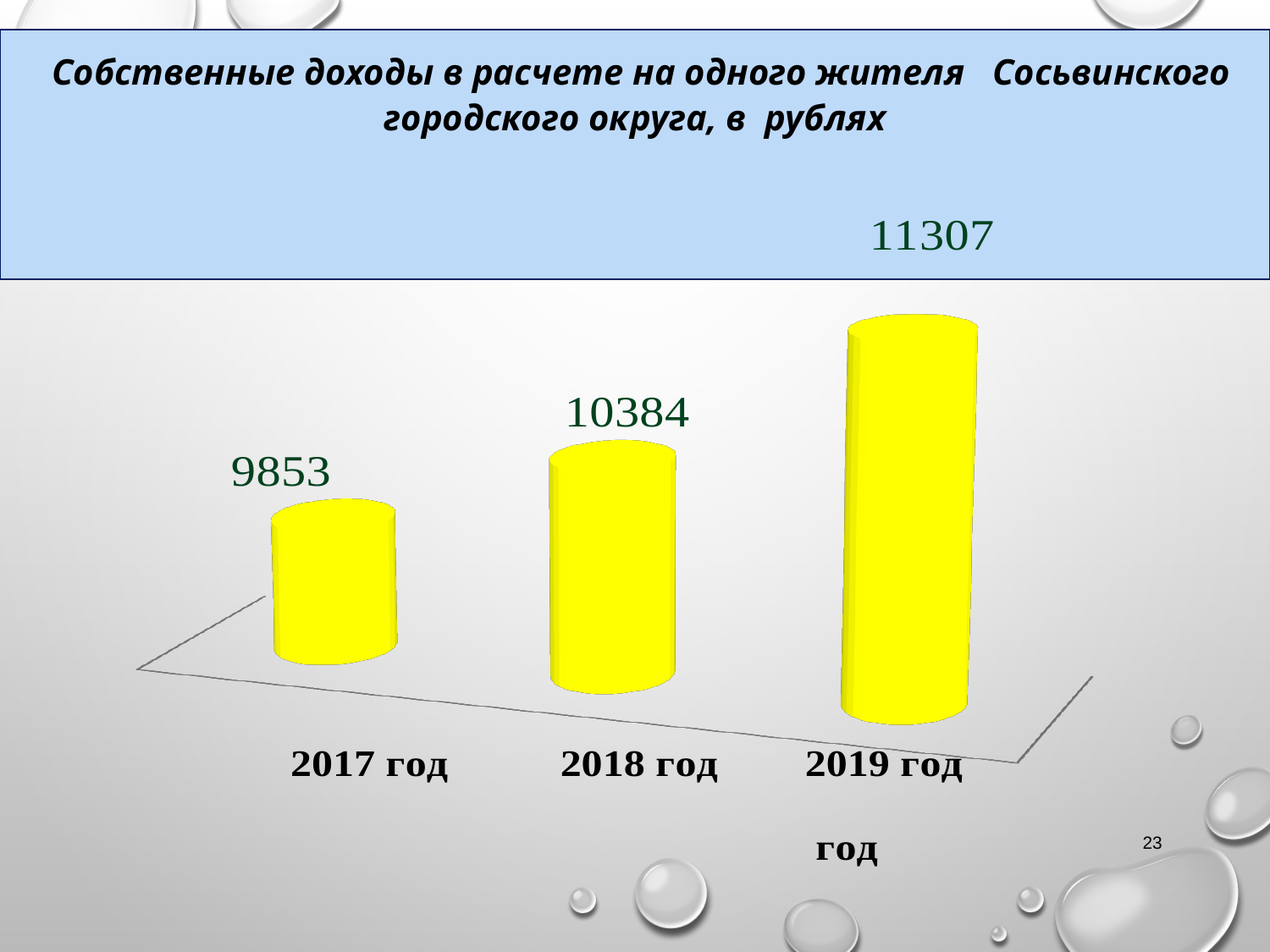
Which year has the highest value? 2019 год What kind of chart is shown? bar chart What colour are the bars on the chart? yellow What is the value for 2017 год? 9853 What is the value for 2018 год? 10384 How many years are shown on the chart? 3 What is the value for 2019 год? 11307 What is the difference between the values for 2018 год and 2017 год? 531 What is the difference between the values for 2019 год and 2017 год? 1454 Do the values rise or fall from 2017 год to 2019 год? rise Which year has the lowest value? 2017 год Which is larger, the value for 2018 год or the value for 2019 год? 2019 год